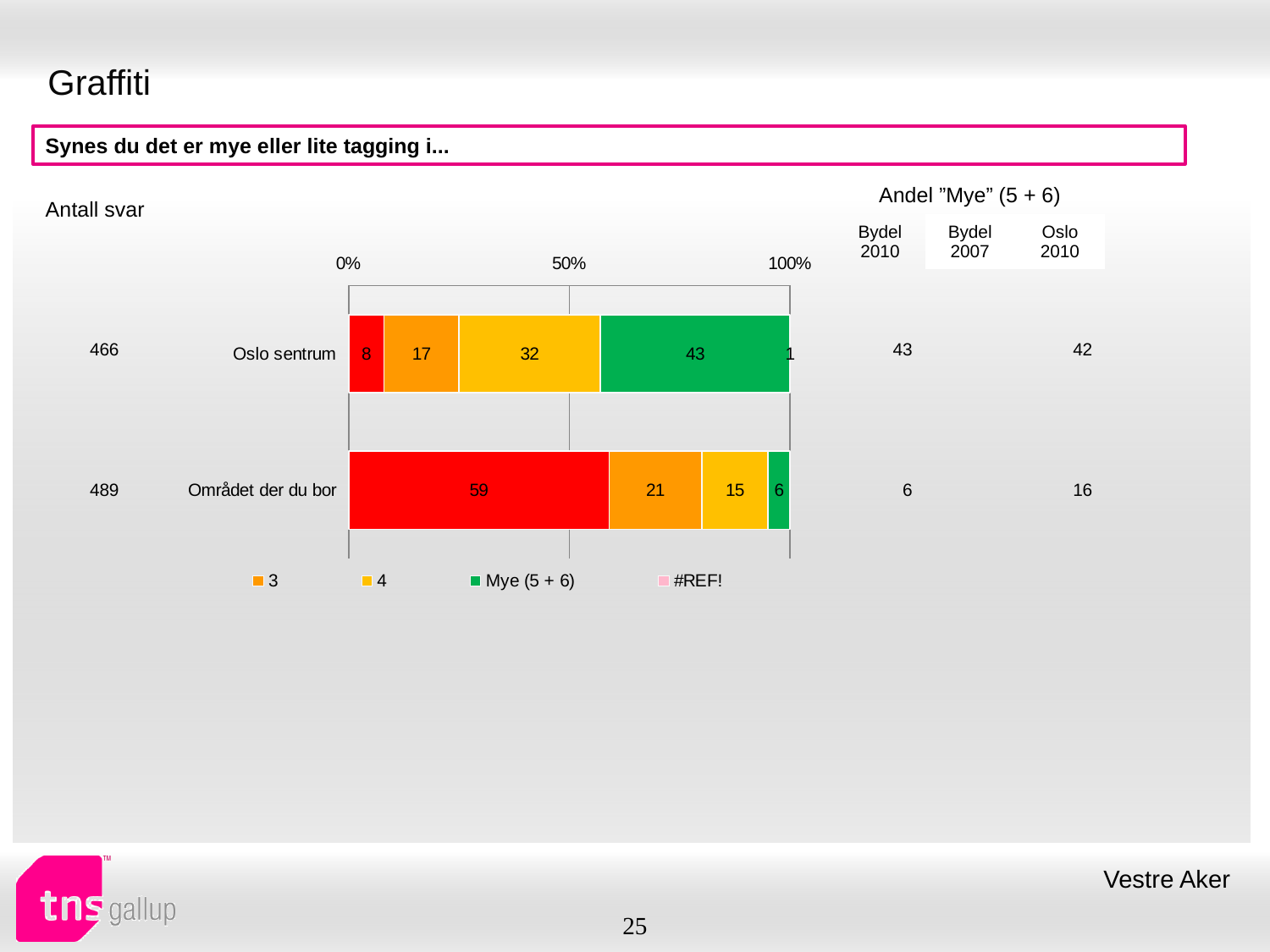
Which category has the higher "Mye (5 + 6)" value, Oslo sentrum or Området der du bor? Oslo sentrum What is the value of the "3" segment for Området der du bor? 21 What is the value of the red segment for Området der du bor? 59 What is the value of the "Mye (5 + 6)" segment for Området der du bor? 6 What is the difference between the "Mye (5 + 6)" values for Oslo sentrum and Området der du bor? 37 What is the difference between the "4" values for Oslo sentrum and Området der du bor? 17 How many series does the chart legend list? 4 What is the number of responses (Antall svar) shown for Oslo sentrum? 466 What kind of chart is shown on the slide? Stacked bar chart What is the value of the "Mye (5 + 6)" segment for Oslo sentrum? 43 How many categories are plotted in the chart? 2 What is the value of the "4" segment for Oslo sentrum? 32